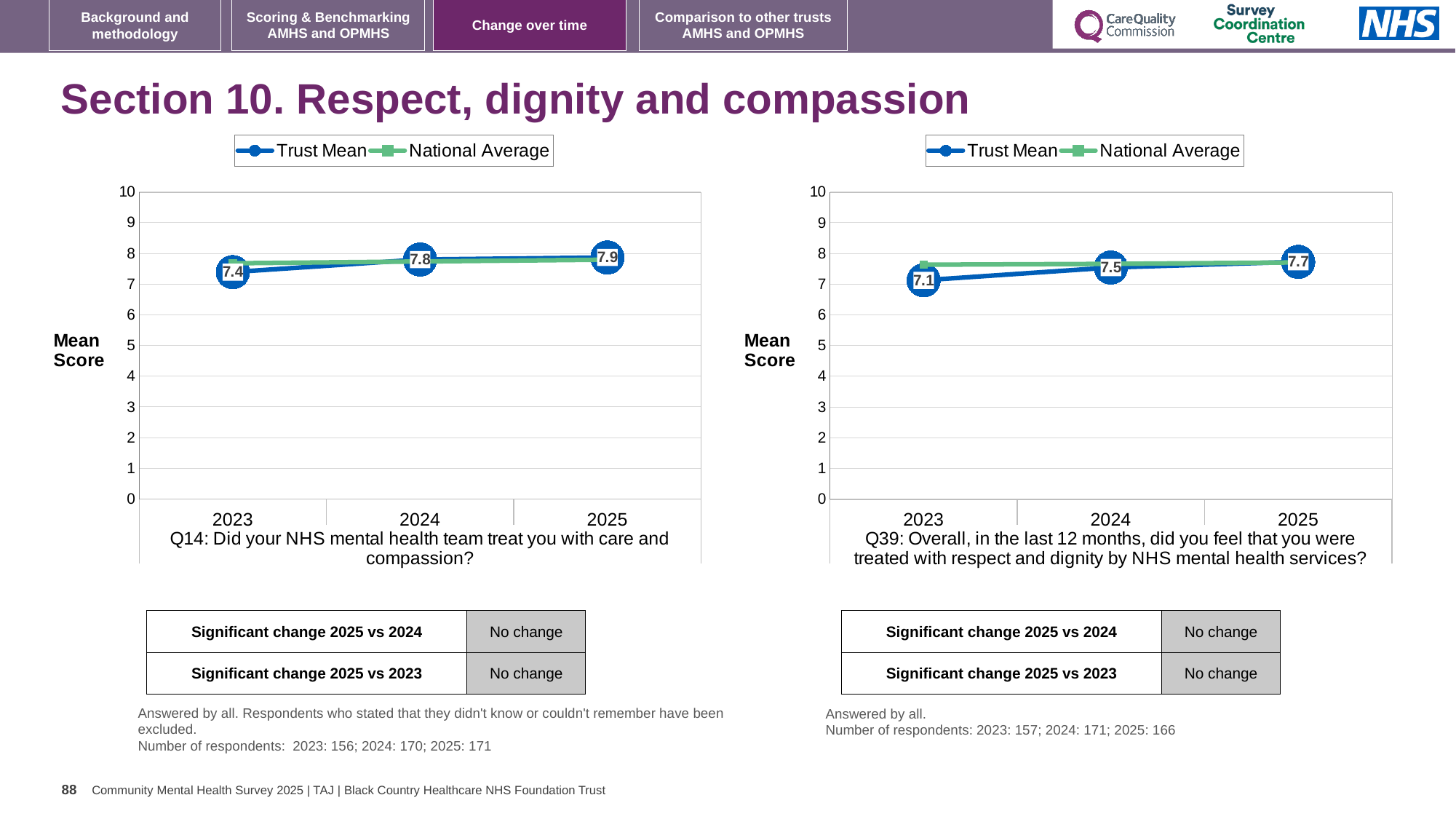
In the left chart (Q14), what is the Trust Mean score for 2025? 7.9 What kind of chart is the right chart (Q39)? line chart In the right chart (Q39), which year has the lowest Trust Mean score? 2023 In the right chart (Q39), what is the difference between the Trust Mean scores for 2025 and 2023? 0.6 In the left chart (Q14), what is the Trust Mean score for 2023? 7.4 In the left chart (Q14), what is the difference between the Trust Mean scores for 2025 and 2023? 0.5 In the left chart (Q14), is the Trust Mean score for 2023 greater or less than 8? less How many series does the legend of the left chart (Q14) list? 2 In the right chart (Q39), what is the Trust Mean score for 2024? 7.5 In the left chart (Q14), which year has the highest Trust Mean score? 2025 In the right chart (Q39), what is the Trust Mean score for 2023? 7.1 In the right chart (Q39), does the Trust Mean rise or fall from 2023 to 2025? rise